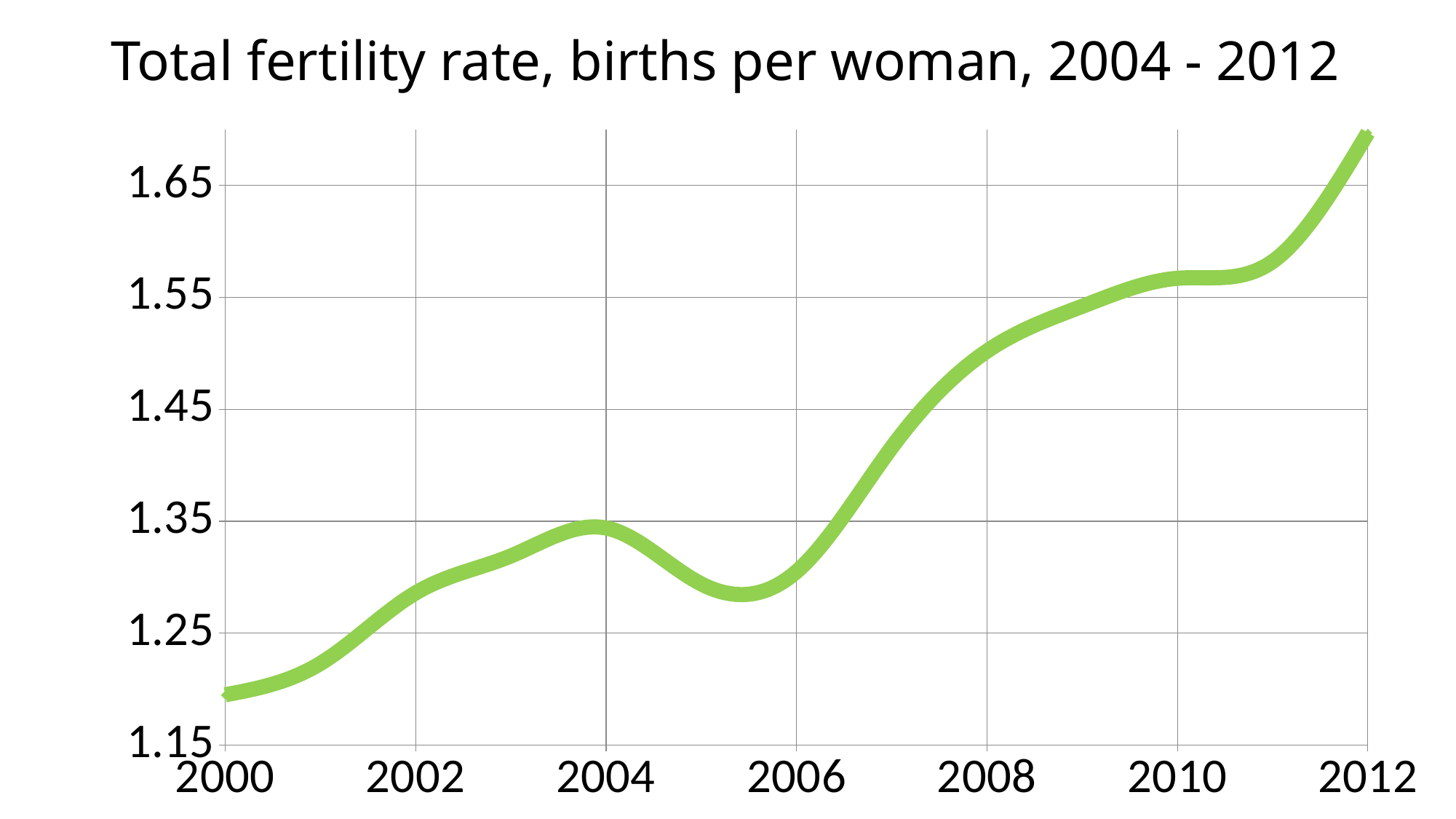
Is the value for 2008 greater or less than 1.45? greater Is the value for 2006 greater or less than 1.35? less In which year shown on the x axis is the total fertility rate lowest? 2000 Which year has the larger total fertility rate, 2004 or 2008? 2008 How many year labels are shown on the x axis? 7 Is the value for 2010 greater or less than 1.45? greater What kind of chart is shown on the slide? line chart What is the title of the chart? Total fertility rate, births per woman, 2004 - 2012 Overall, does the total fertility rate rise or fall from 2000 to 2012? rise In which year shown on the x axis is the total fertility rate highest? 2012